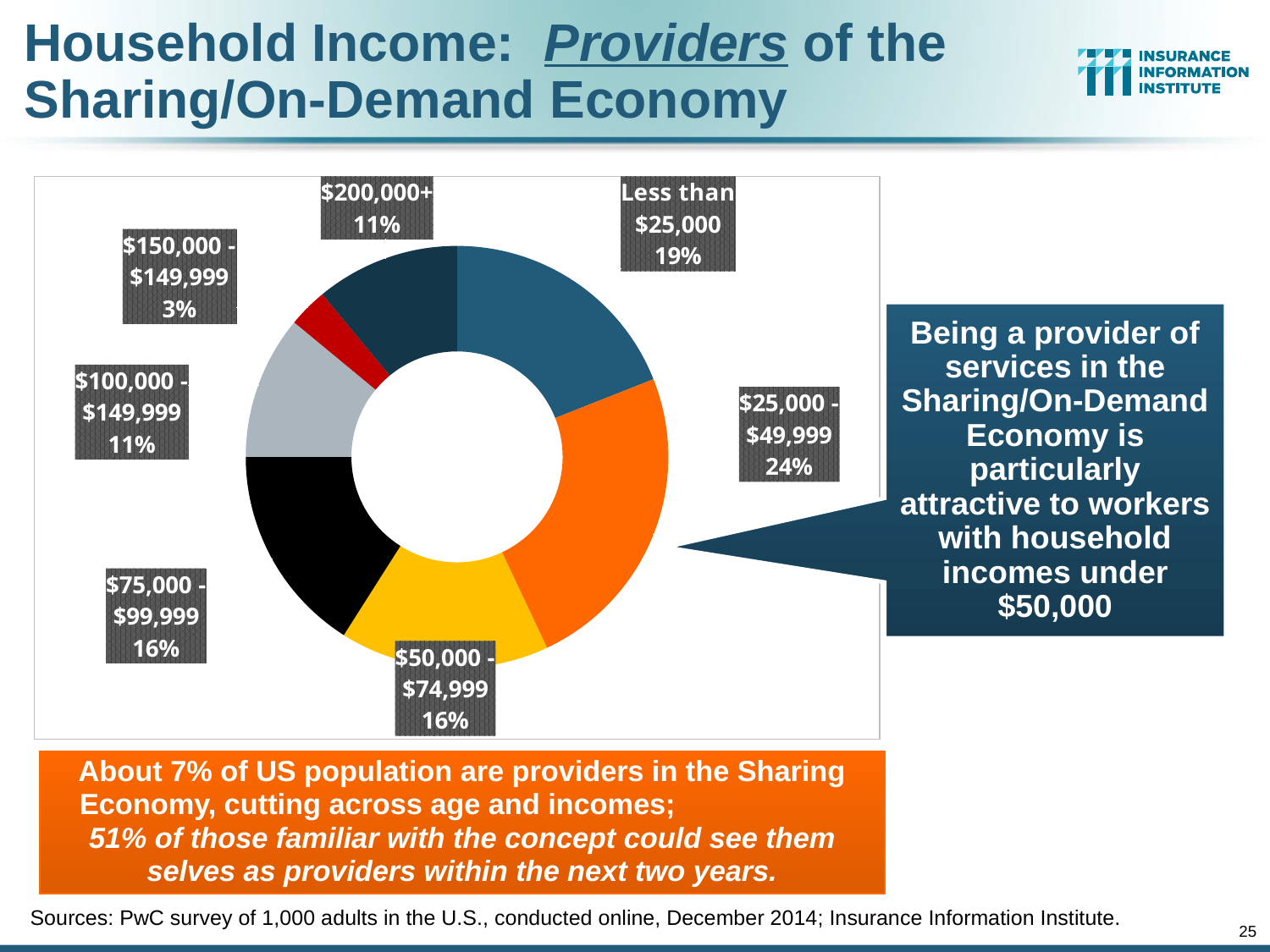
Which household income bracket has the largest share of providers? $25,000 - $49,999 What share of providers have a household income of $200,000+? 11% Which household income bracket has the smallest share of providers? $150,000 - $149,999 (3%) What is the difference in percentage points between the $25,000 - $49,999 bracket and the Less than $25,000 bracket? 5 percentage points Which has a larger share: Less than $25,000 or $75,000 - $99,999? Less than $25,000 What share of providers have a household income of less than $25,000? 19% What percentage of providers fall in the $25,000 - $49,999 household income bracket? 24% What colour is the slice for the $25,000 - $49,999 bracket? Orange What is the combined share of providers with household incomes under $50,000? 43% How many household income brackets are shown in the chart? 7 What kind of chart is shown on the slide? Doughnut chart What percentage is shown for the $75,000 - $99,999 income bracket? 16%